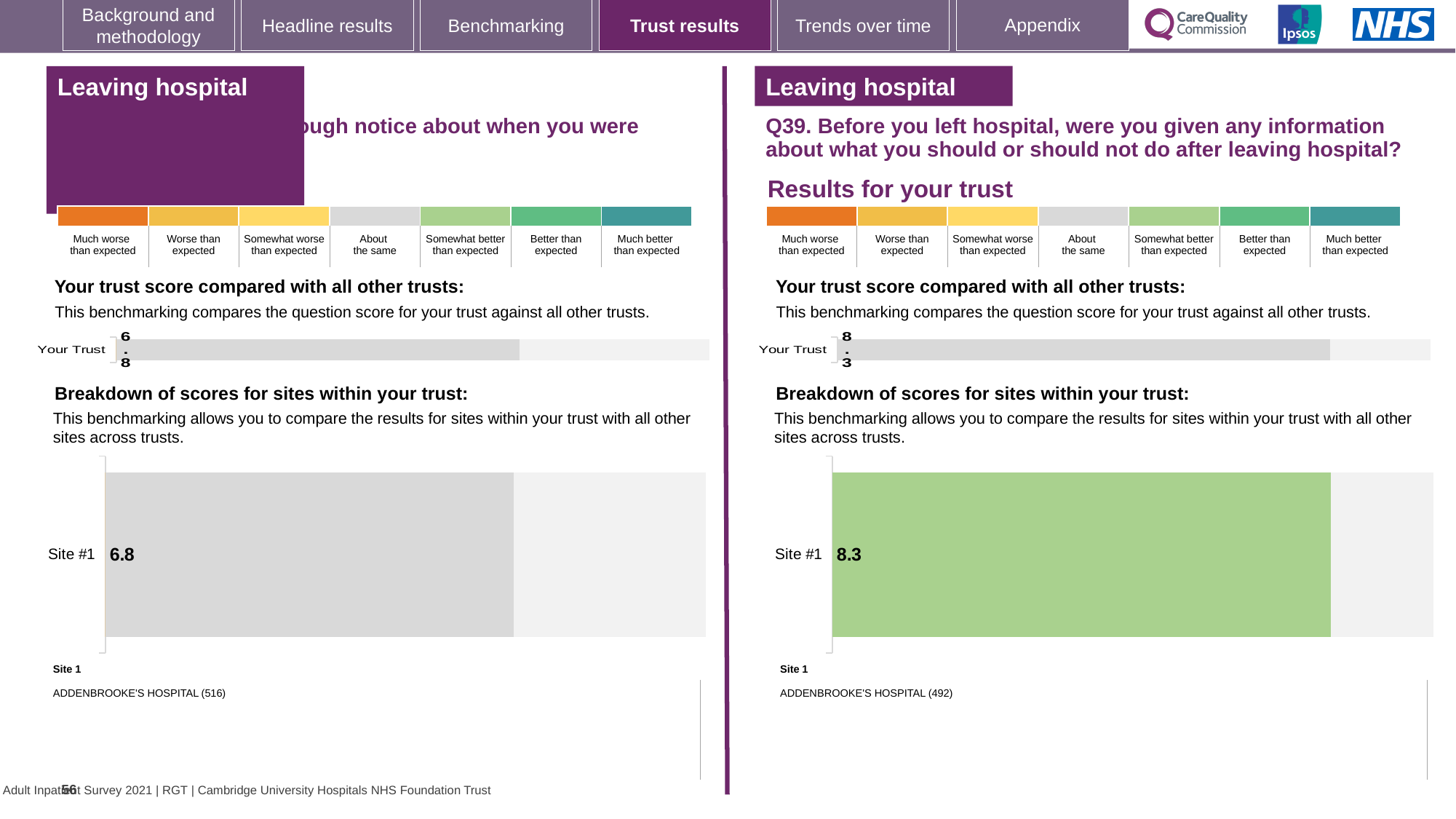
Which is larger: the Site #1 score on the left half of the slide or the Site #1 score on the right half (Q39)? Right half (Q39) On the right half of the slide (Q39), what score is shown for Site #1 in the 'Breakdown of scores for sites within your trust' chart? 8.3 What is the difference between the Site #1 score on the right half of the slide (Q39) and the Site #1 score on the left half? 1.5 On the left half of the slide, what is the score shown for Your Trust in the 'Your trust score compared with all other trusts' chart? 6.8 On the right half of the slide (Q39), which benchmark category does the colour of the Site #1 bar correspond to? Somewhat better than expected On the left half of the slide, which benchmark category does the colour of the Site #1 bar correspond to? About the same On the left half of the slide, what score is shown for Site #1 in the 'Breakdown of scores for sites within your trust' chart? 6.8 What type of chart is used to show the Site #1 score on the left half of the slide? Bar chart On the right half of the slide (Q39), what is the score shown for Your Trust in the 'Your trust score compared with all other trusts' chart? 8.3 Which site name is listed as Site 1 below the chart on the left half of the slide? ADDENBROOKE'S HOSPITAL (516) How many sites are shown in the 'Breakdown of scores for sites within your trust' chart on the right half of the slide (Q39)? 1 Which site name is listed as Site 1 below the chart on the right half of the slide (Q39)? ADDENBROOKE'S HOSPITAL (492)